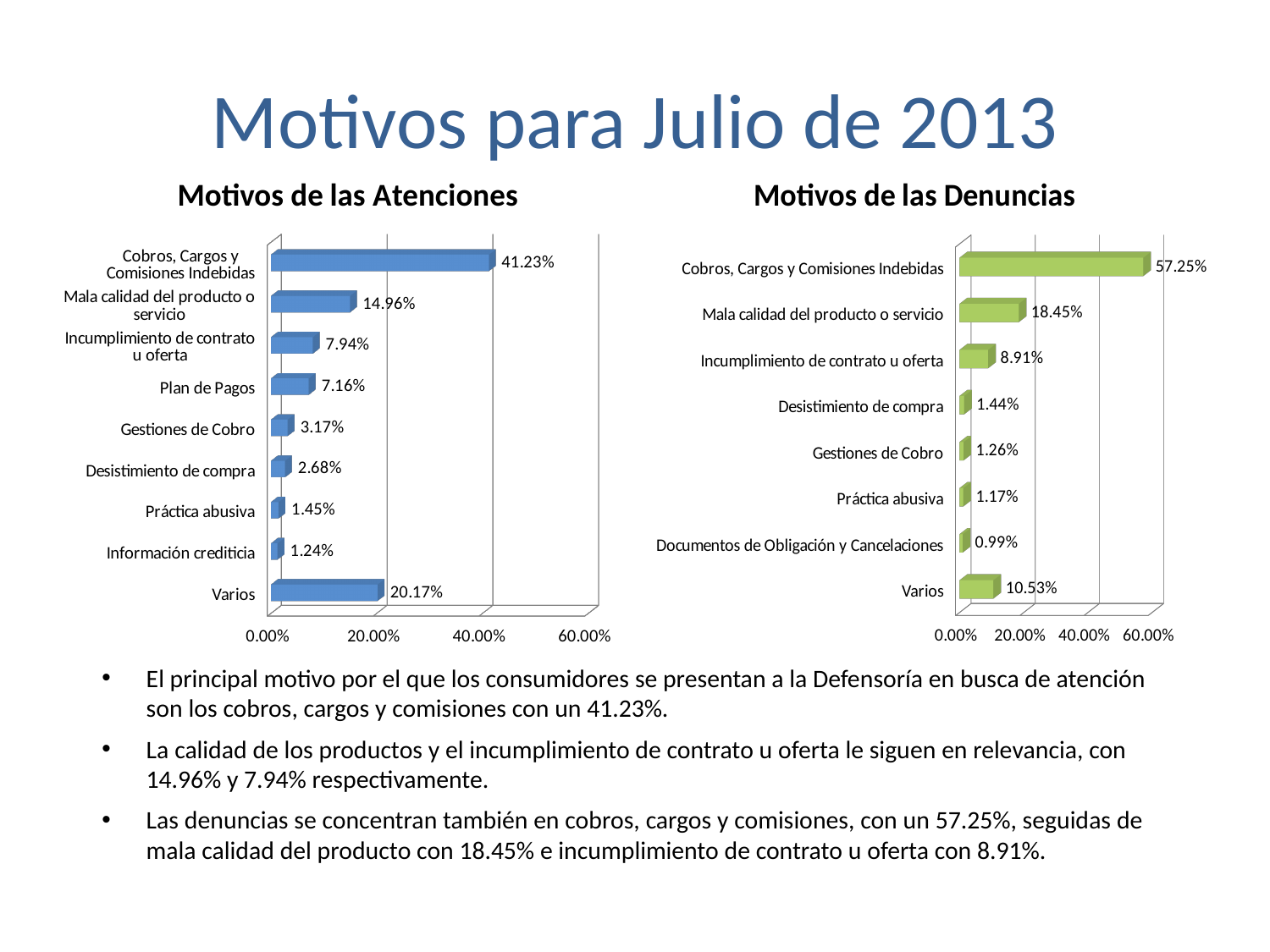
In the 'Motivos de las Denuncias' chart, what is the difference between Cobros, Cargos y Comisiones Indebidas and Mala calidad del producto o servicio? 38.80% In the 'Motivos de las Denuncias' chart, is the value for Cobros, Cargos y Comisiones Indebidas greater or less than 40.00%? greater Which is larger: Varios in the 'Motivos de las Atenciones' chart or Varios in the 'Motivos de las Denuncias' chart? Varios in Motivos de las Atenciones What type of chart is the 'Motivos de las Denuncias' chart? Bar chart In the 'Motivos de las Atenciones' chart, which category has the lowest value? Información crediticia In the 'Motivos de las Denuncias' chart, what is the value for Desistimiento de compra? 1.44% How many categories are shown in the 'Motivos de las Denuncias' chart? 8 In the 'Motivos de las Denuncias' chart, which category has the lowest value? Documentos de Obligación y Cancelaciones In the 'Motivos de las Atenciones' chart, which category has the highest value? Cobros, Cargos y Comisiones Indebidas In the 'Motivos de las Atenciones' chart, what is the difference between Varios and Mala calidad del producto o servicio? 5.21% How many categories are shown in the 'Motivos de las Atenciones' chart? 9 In the 'Motivos de las Atenciones' chart, what is the value for Plan de Pagos? 7.16%